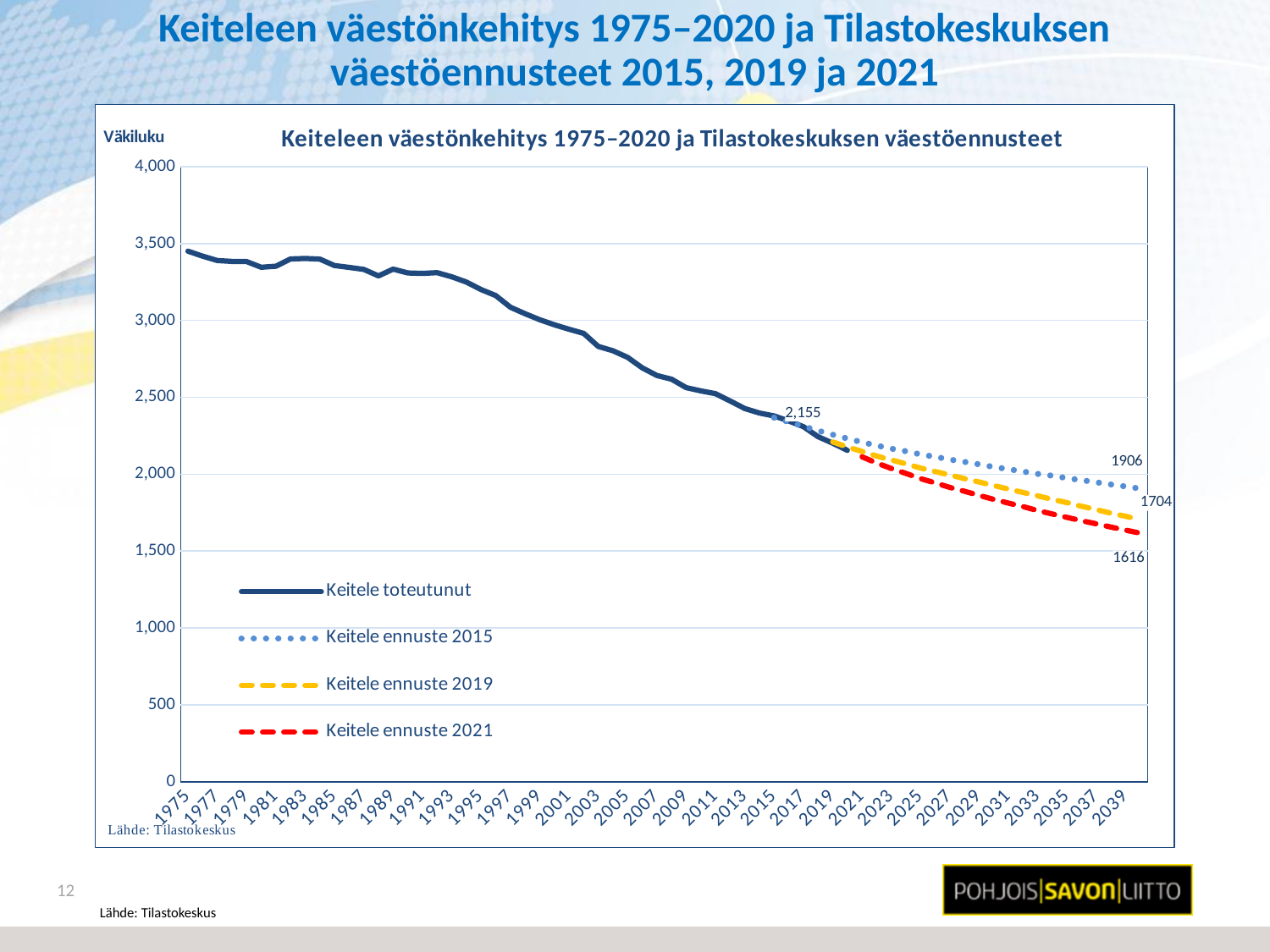
What is the label on the vertical axis of the chart? Väkiluku Which forecast series ends at the lowest value? Keitele ennuste 2021 Which ends higher, Keitele ennuste 2015 or Keitele ennuste 2021? Keitele ennuste 2015 Does the Keitele toteutunut series rise or fall from 1975 to 2020? fall What is the final labelled value of the Keitele ennuste 2021 series? 1616 What is the final labelled value of the Keitele ennuste 2019 series? 1704 How many series does the legend list? 4 What kind of chart is shown on the slide? line chart What is the final labelled value of the Keitele ennuste 2015 series? 1906 What is the difference between the final labelled values of Keitele ennuste 2015 (1906) and Keitele ennuste 2021 (1616)? 290 What is the difference between the final labelled values of Keitele ennuste 2015 (1906) and Keitele ennuste 2019 (1704)? 202 Is the Keitele toteutunut value in 1975 greater or less than 3,000? greater